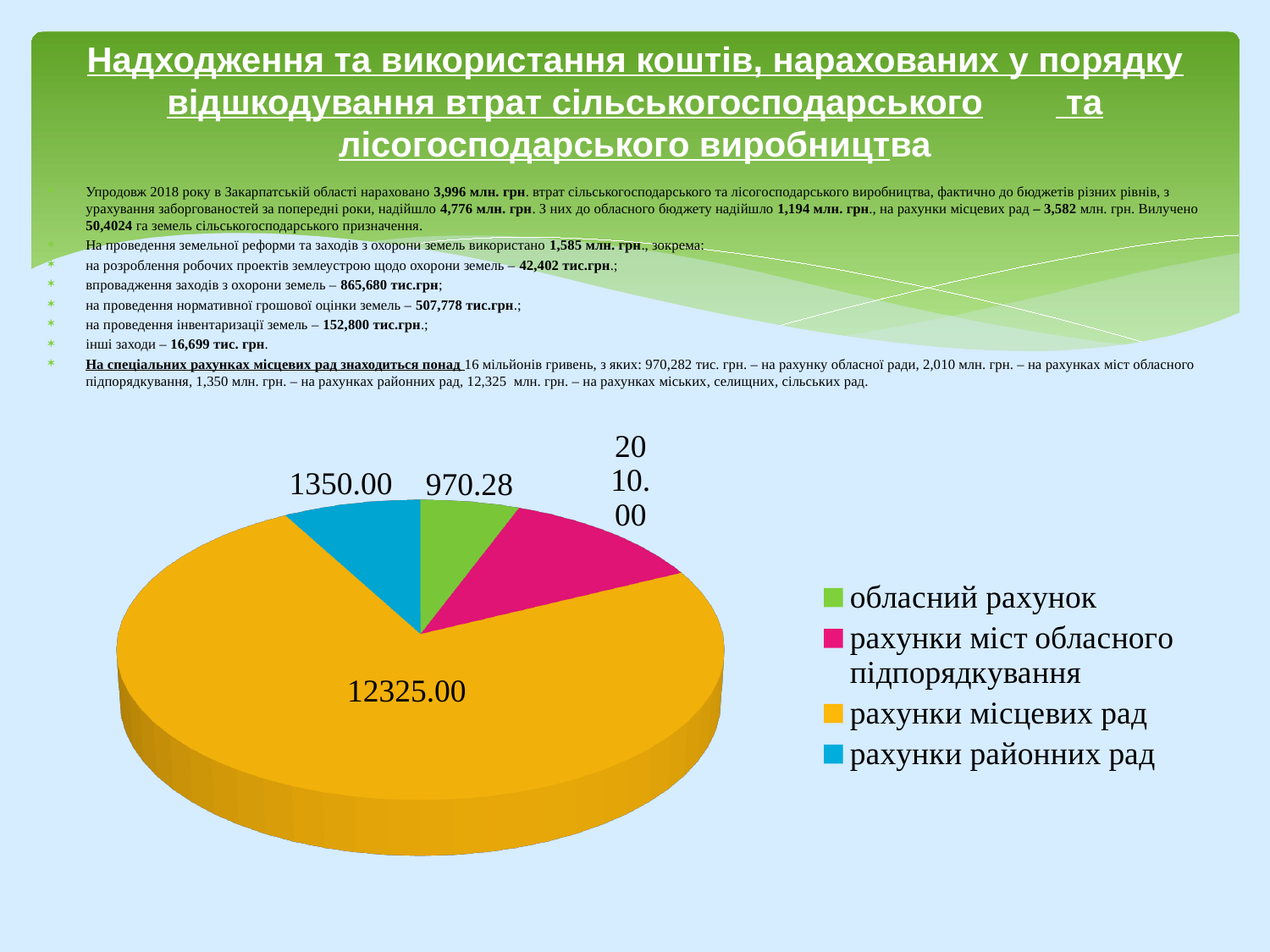
What is the value shown for обласний рахунок? 970.28 Which category has the smallest slice in the pie chart? обласний рахунок What is the difference between the value for рахунки місцевих рад and the value for рахунки районних рад? 10975.00 What kind of chart is shown on the slide? pie chart Which category has the largest slice in the pie chart? рахунки місцевих рад How many slices does the pie chart have? 4 How many entries does the legend of the pie chart list? 4 What is the value shown for рахунки районних рад? 1350.00 What colour is the slice for рахунки місцевих рад? yellow Which is larger, the value for рахунки районних рад or the value for обласний рахунок? рахунки районних рад What is the value shown for рахунки міст обласного підпорядкування? 2010.00 What is the value shown for рахунки місцевих рад? 12325.00